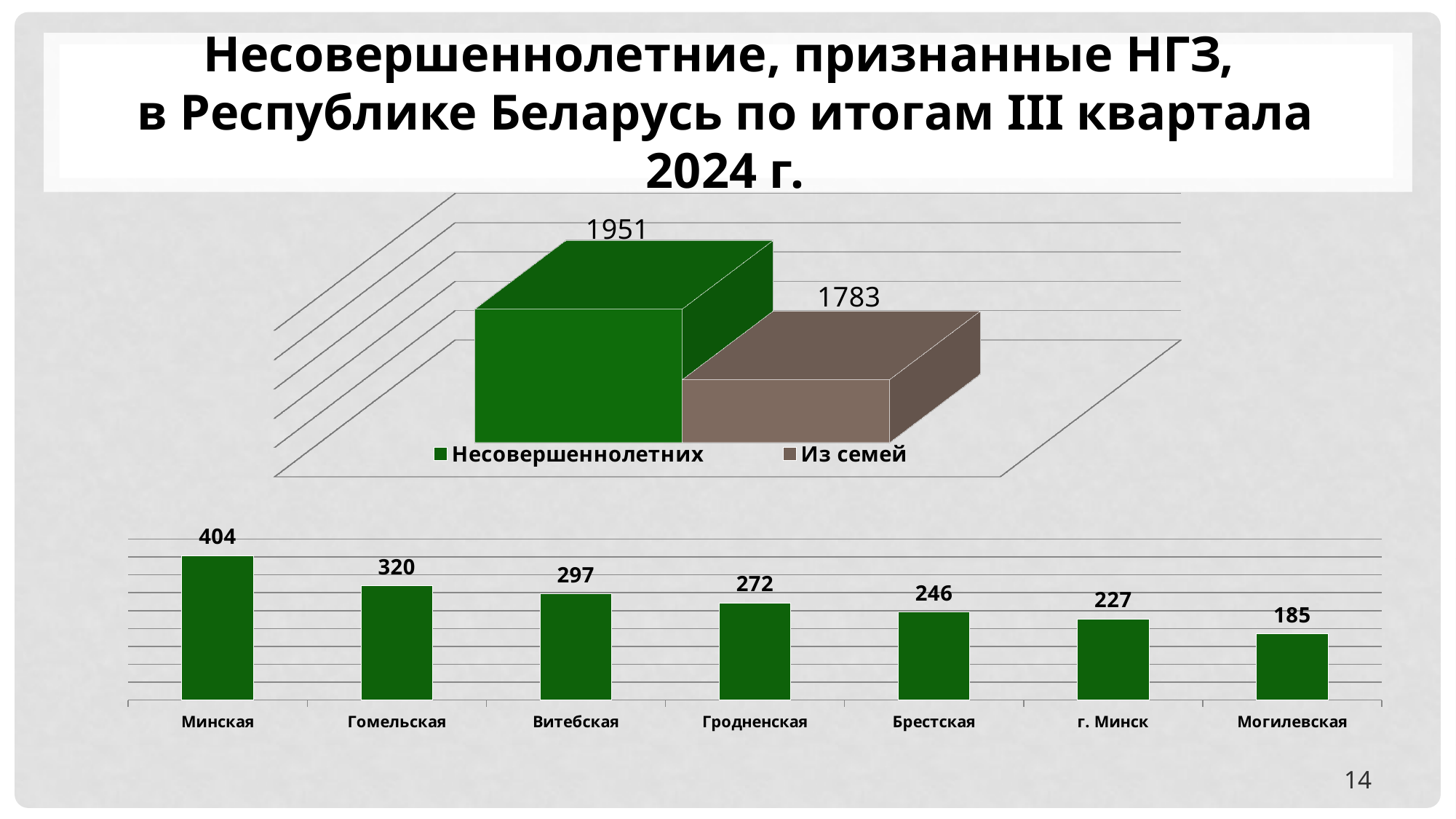
In the bottom chart, which is larger, Гродненская or г. Минск? Гродненская In the bottom chart, how many categories are shown? 7 In the bottom chart, what is the value for Минская? 404 In the top chart, what is the value for Несовершеннолетних? 1951 In the bottom chart, which category has the lowest value? Могилевская In the bottom chart, do the values rise or fall from left to right? fall In the bottom chart, what is the difference between Гомельская and Витебская? 23 In the bottom chart, which category has the highest value? Минская In the top chart, how many series does the legend list? 2 In the bottom chart, what is the value for Брестская? 246 In the top chart, what is the value for Из семей? 1783 In the top chart, what is the difference between Несовершеннолетних and Из семей? 168